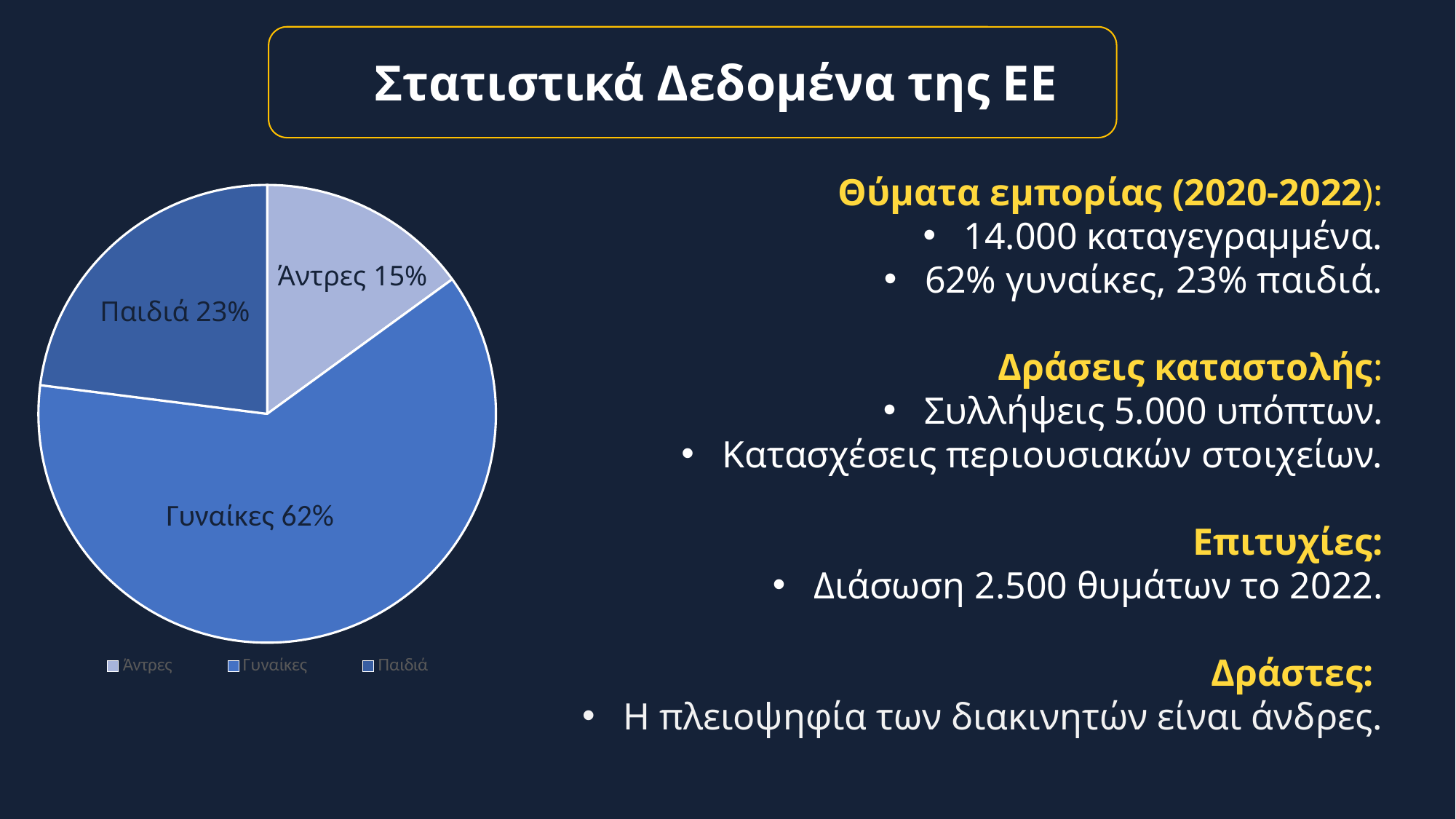
Which category has the largest slice of the pie? Γυναίκες What share of the pie does Παιδιά represent? 23% What share of the pie does Άντρες represent? 15% Which is larger, the slice for Παιδιά or the slice for Άντρες? Παιδιά What share of the pie does Γυναίκες represent? 62% How many slices does the pie chart have? 3 What kind of chart is shown on the slide? pie chart How many entries does the legend list? 3 What is the difference in percentage points between Παιδιά and Άντρες? 8 What is the difference in percentage points between Γυναίκες and Παιδιά? 39 Which category has the smallest slice of the pie? Άντρες Which legend entry is shown with the lightest colour? Άντρες